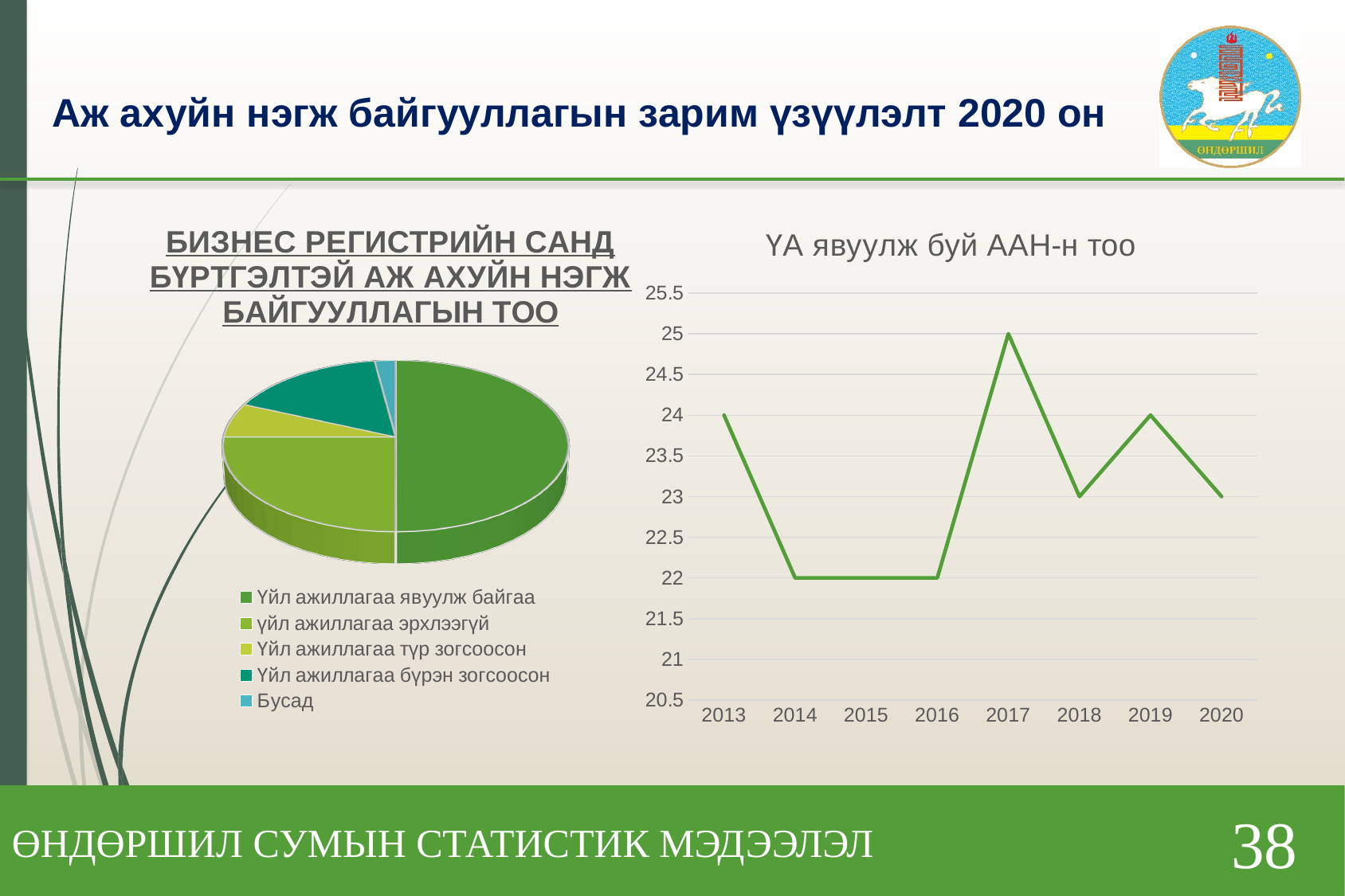
On the chart titled 'ҮА явуулж буй ААН-н тоо', which is larger, the value for 2019 or the value for 2018? 2019 On the chart titled 'ҮА явуулж буй ААН-н тоо', what is the difference between the values for 2017 and 2020? 2 How many categories does the legend of the pie chart on the left list? 5 On the chart titled 'ҮА явуулж буй ААН-н тоо', which year has the highest value? 2017 On the chart titled 'ҮА явуулж буй ААН-н тоо', what is the value for 2017? 25 On the chart titled 'ҮА явуулж буй ААН-н тоо', what is the value for 2013? 24 What kind of chart is the one titled 'ҮА явуулж буй ААН-н тоо'? line chart What kind of chart is the one on the left titled 'БИЗНЕС РЕГИСТРИЙН САНД БҮРТГЭЛТЭЙ АЖ АХУЙН НЭГЖ БАЙГУУЛЛАГЫН ТОО'? pie chart On the chart titled 'ҮА явуулж буй ААН-н тоо', how many years are plotted on the x axis? 8 On the chart titled 'ҮА явуулж буй ААН-н тоо', what is the value for 2020? 23 On the chart titled 'ҮА явуулж буй ААН-н тоо', is the value for 2015 greater or less than 23? less On the chart titled 'ҮА явуулж буй ААН-н тоо', does the value rise or fall from 2013 to 2014? fall